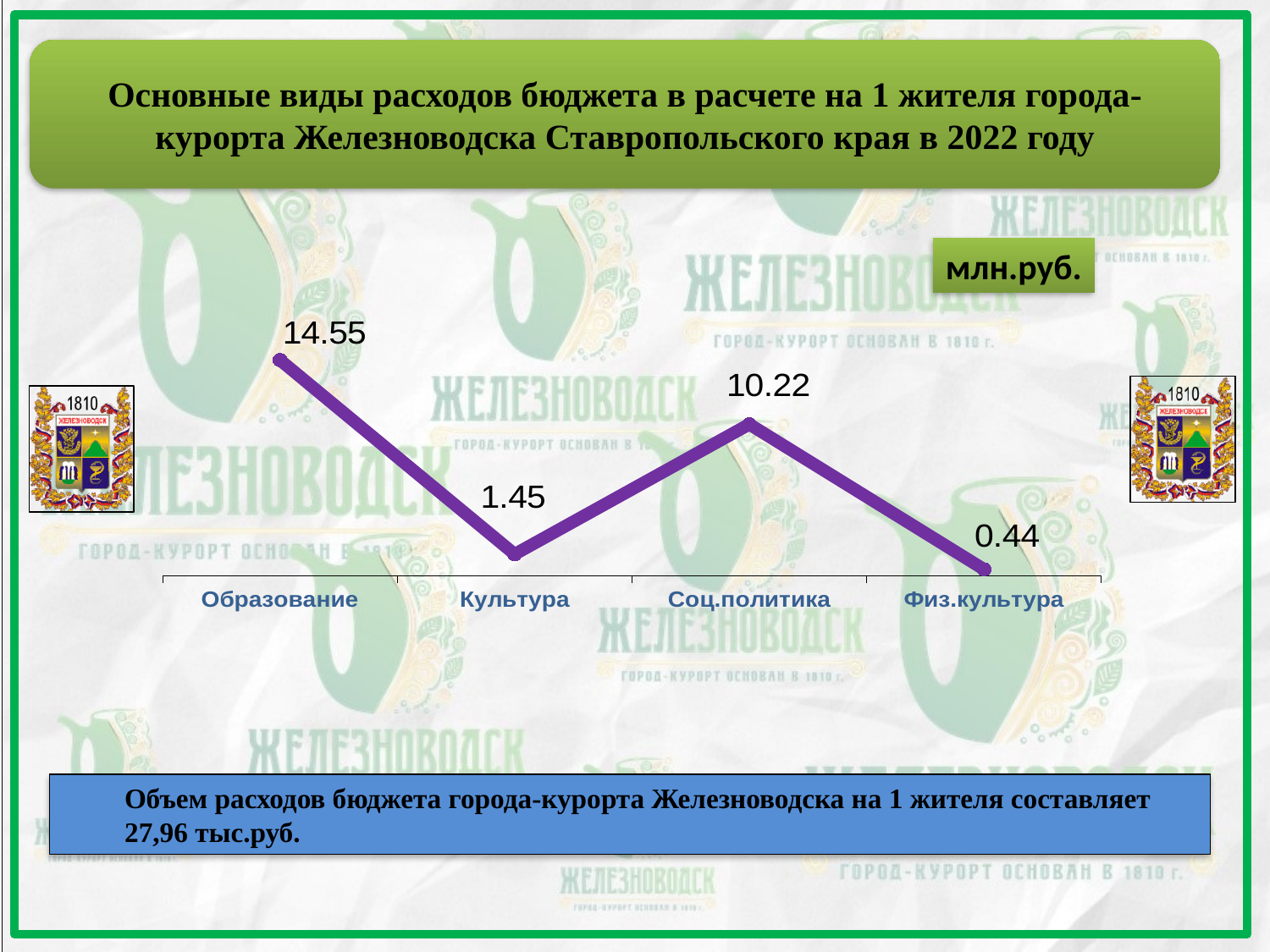
Which category has the highest value? Образование What is the difference between the values for Образование and Соц.политика? 4.33 What is the value for Культура? 1.45 What kind of chart is shown on the slide? Line chart What unit is indicated for the chart values? млн.руб. Which category has the lowest value? Физ.культура What is the value for Физ.культура? 0.44 What is the value for Образование? 14.55 What is the difference between the values for Культура and Физ.культура? 1.01 Which is larger, the value for Культура or the value for Соц.политика? Соц.политика How many categories are plotted on the chart? 4 What is the value for Соц.политика? 10.22